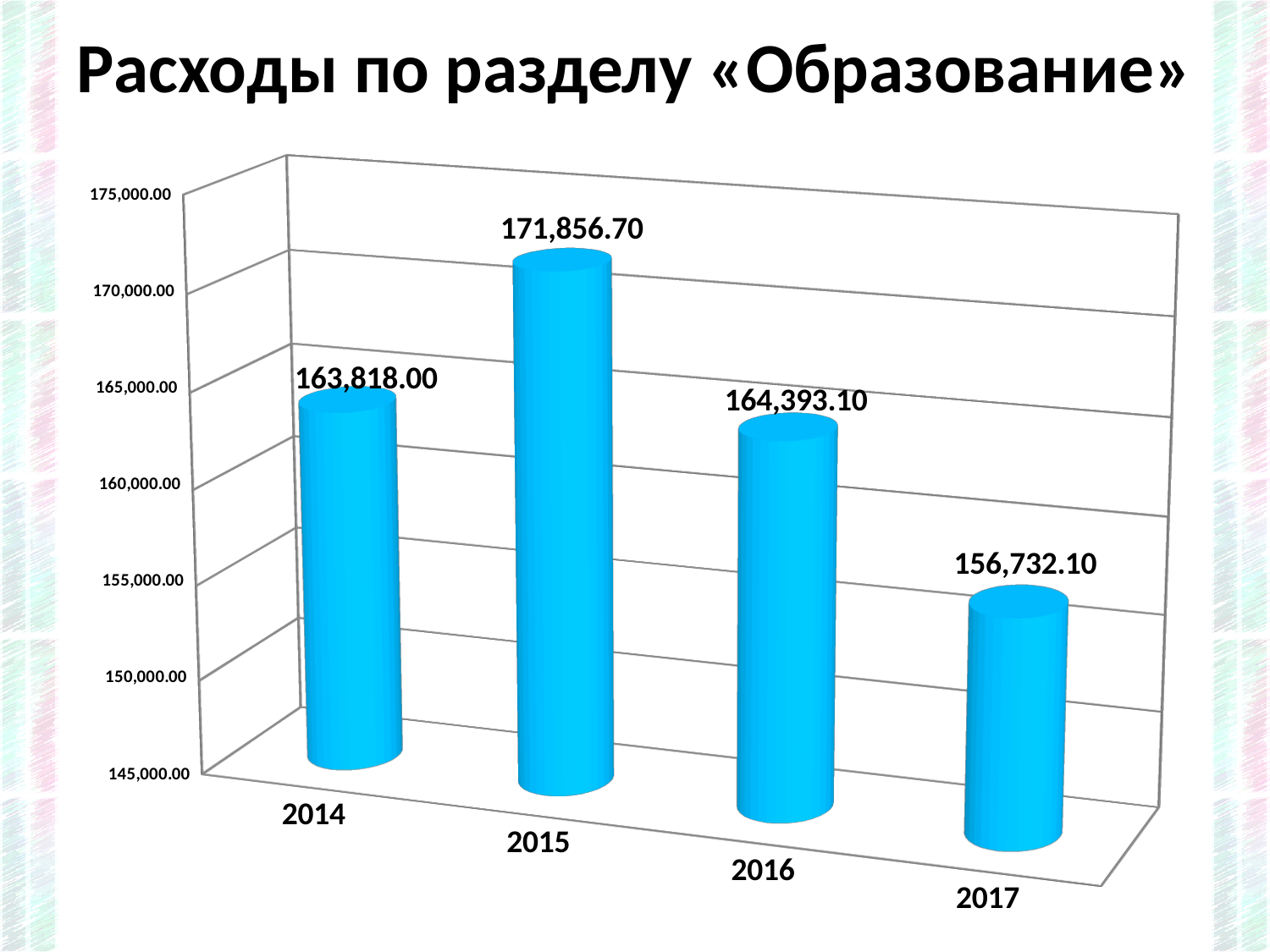
What is the difference between the values for 2016 and 2017? 7,661.00 How many years are shown on the chart? 4 Which is larger, the value for 2014 or the value for 2016? 2016 What is the value for 2016? 164,393.10 Which year has the highest value? 2015 What is the value for 2014? 163,818.00 What kind of chart is this? Bar chart What is the value for 2017? 156,732.10 What is the title of the chart? Расходы по разделу «Образование» Which year has the lowest value? 2017 What is the difference between the values for 2015 and 2014? 8,038.70 What is the value for 2015? 171,856.70